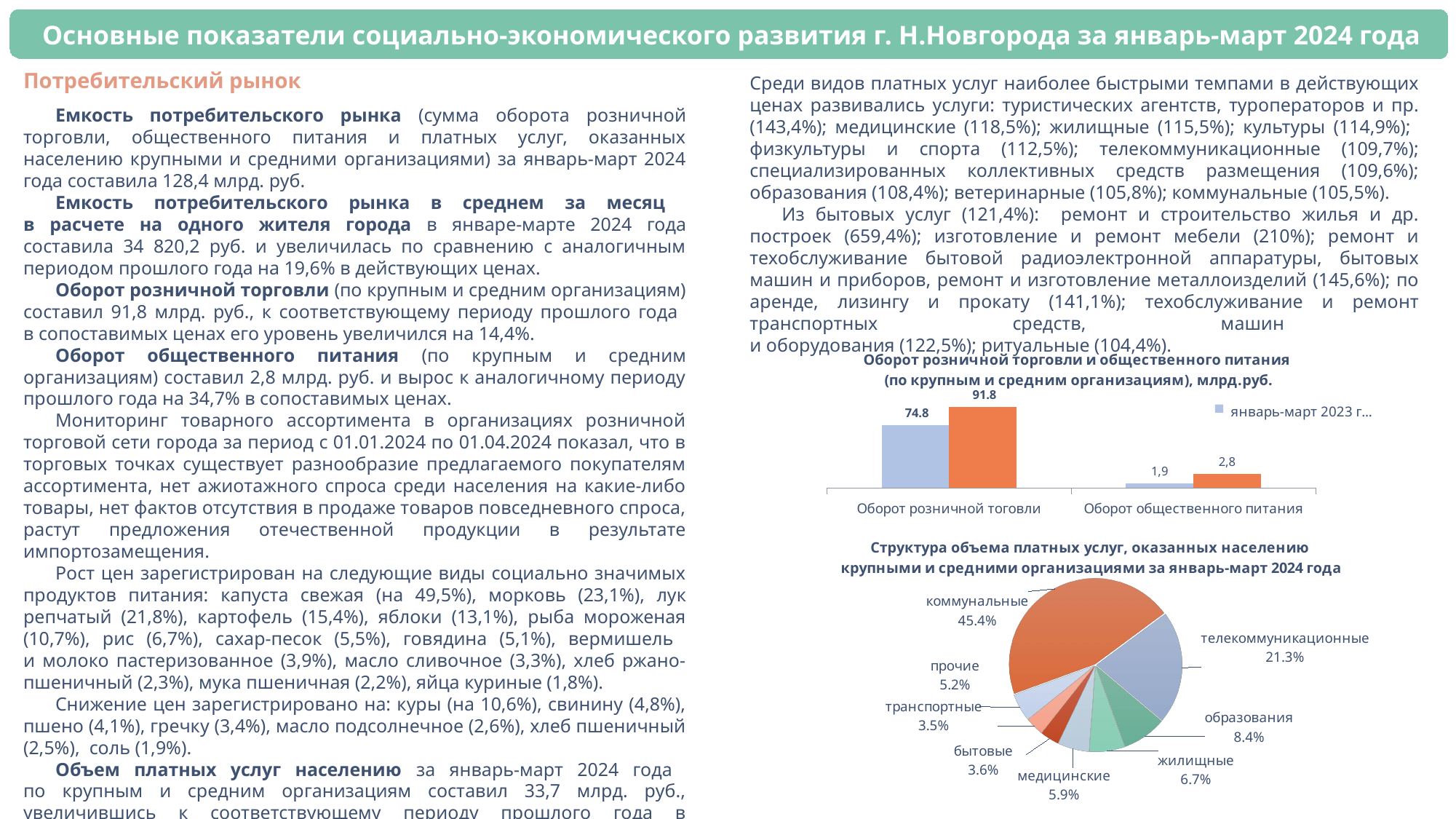
In the bar chart 'Оборот розничной торговли и общественного питания', what is the value of the blue bar (январь-март 2023 г.) for Оборот розничной тоговли? 74.8 In the pie chart 'Структура объема платных услуг', what share do коммунальные services have? 45.4% In the bar chart 'Оборот розничной торговли и общественного питания', what is the difference between the orange and blue bars for Оборот розничной тоговли? 17.0 In the bar chart 'Оборот розничной торговли и общественного питания', how many categories are shown on the x axis? 2 In the pie chart 'Структура объема платных услуг', how many slices are labelled? 8 In the pie chart 'Структура объема платных услуг', which category has the largest share? коммунальные In the bar chart 'Оборот розничной торговли и общественного питания', what is the value of the orange bar for Оборот общественного питания? 2,8 What type of chart is 'Оборот розничной торговли и общественного питания'? bar chart In the pie chart 'Структура объема платных услуг', what is the share of телекоммуникационные services? 21.3% In the pie chart 'Структура объема платных услуг', which is larger: образования or жилищные? образования In the bar chart 'Оборот розничной торговли и общественного питания', what is the value of the orange bar for Оборот розничной тоговли? 91.8 In the bar chart 'Оборот розничной торговли и общественного питания', what is the value of the blue bar for Оборот общественного питания? 1,9